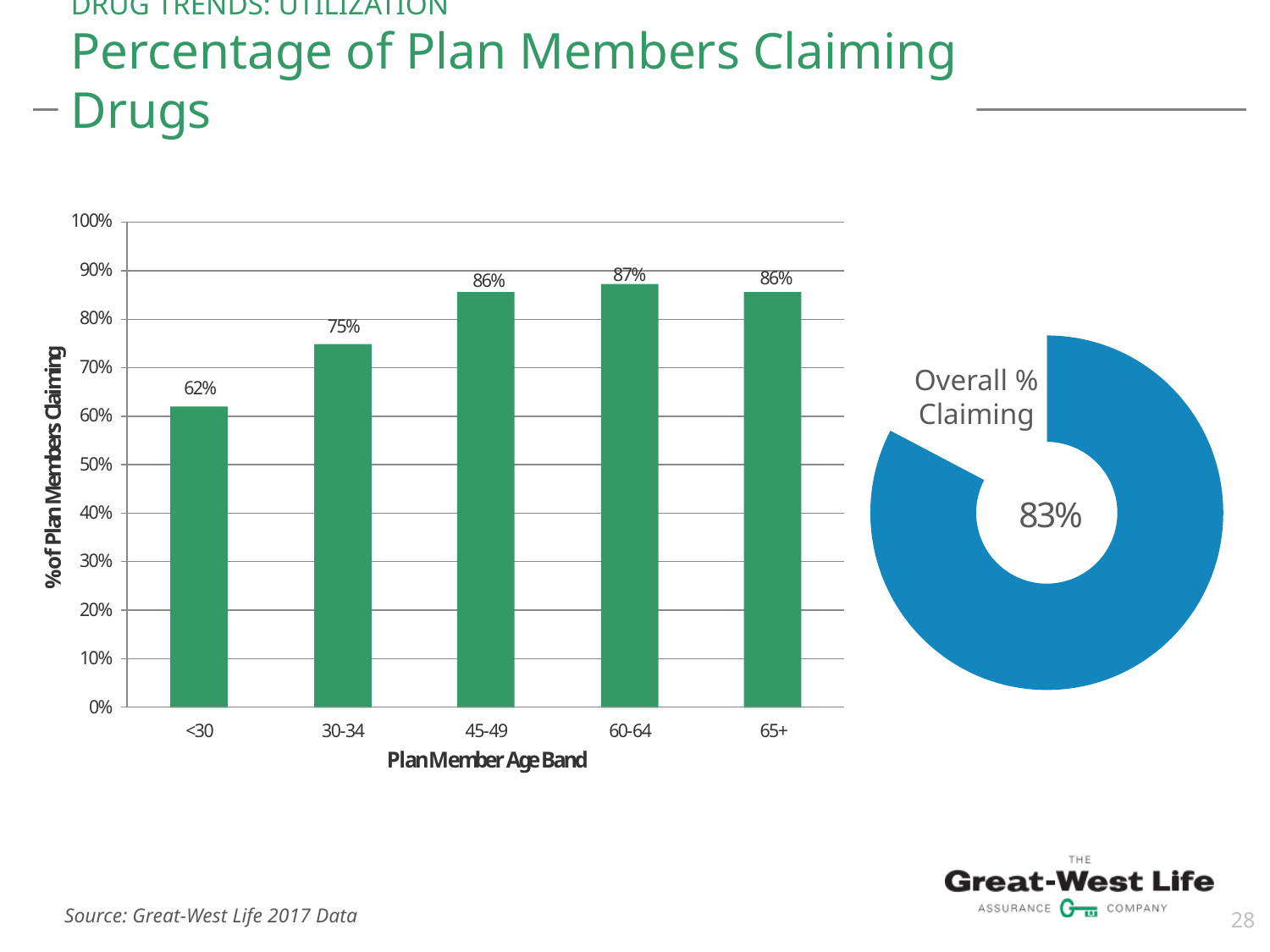
In the bar chart on the left, do the values generally rise or fall from the <30 age band to the 60-64 age band? Rise In the bar chart on the left, what is the difference in percentage points between the 30-34 and <30 age bands? 13 In the bar chart on the left, which age band has a higher percentage claiming, <30 or 45-49? 45-49 In the bar chart on the left, what is the percentage of plan members claiming for the 60-64 age band? 87% In the bar chart on the left, how many age bands are shown on the x axis? 5 What is the x-axis title of the bar chart on the left? Plan Member Age Band In the bar chart on the left, which age band has the lowest percentage of plan members claiming? <30 In the bar chart on the left, which age band has the highest percentage of plan members claiming? 60-64 What kind of chart is shown on the left of the slide? Bar chart In the bar chart on the left, what is the percentage of plan members claiming for the 30-34 age band? 75% In the doughnut chart on the right, what is the overall percentage of plan members claiming? 83% In the bar chart on the left, what is the percentage of plan members claiming for the <30 age band? 62%